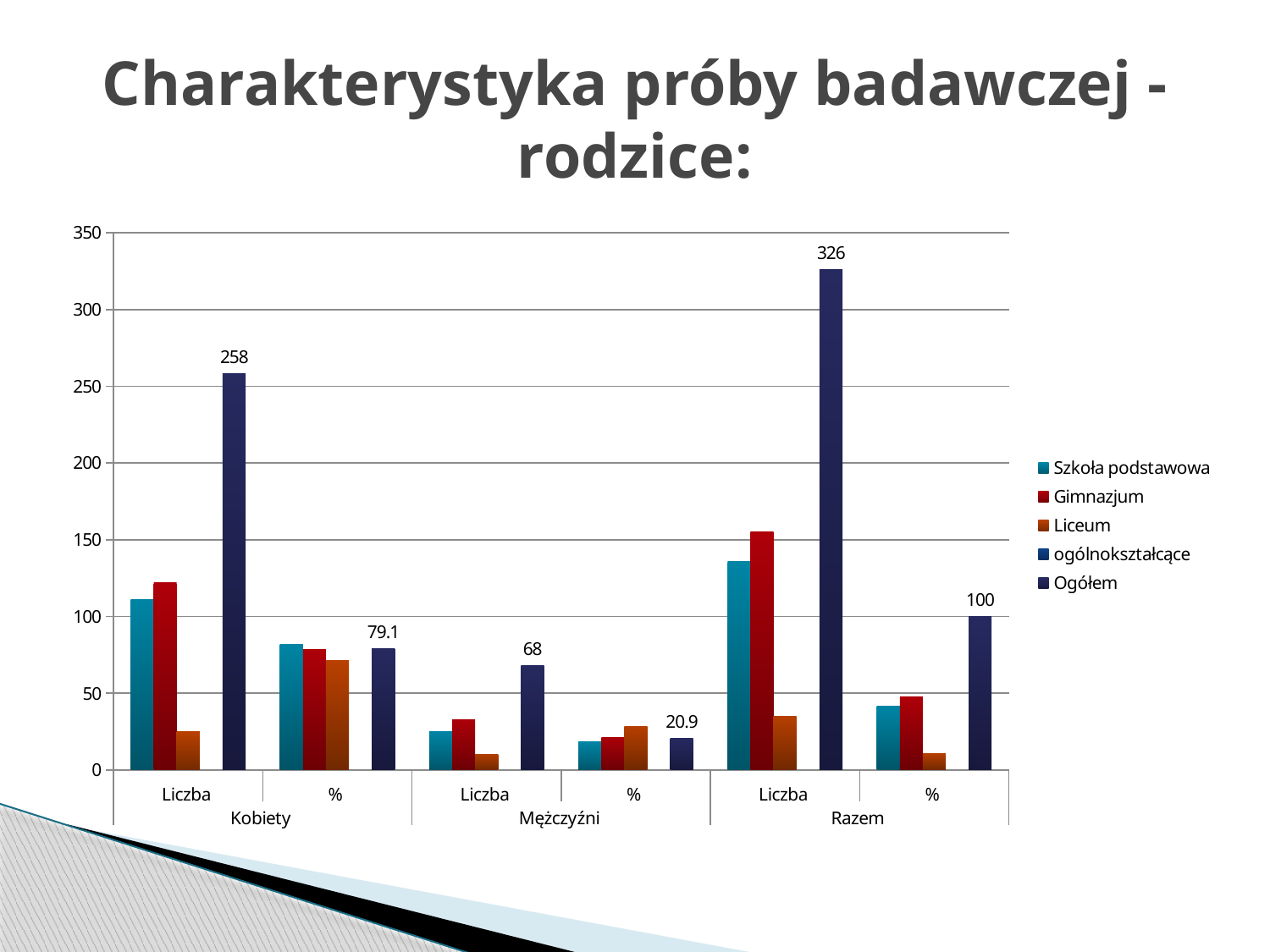
Is the Ogółem value for Mężczyźni Liczba greater or less than the Ogółem value for Kobiety %? less Is the Liceum value for Kobiety Liczba greater or less than 50? less How many series does the legend list? 5 Which category has the lowest Ogółem value? Mężczyźni % Is the Gimnazjum value for Razem Liczba greater or less than 150? greater Which category has the highest Ogółem value? Razem Liczba What kind of chart is shown on the slide? Bar chart What is the Ogółem value for Kobiety %? 79.1 What is the Ogółem value for Mężczyźni %? 20.9 What is the Ogółem value for Kobiety Liczba? 258 What is the difference between the Ogółem values for Razem Liczba and Kobiety Liczba? 68 What is the Ogółem value for Razem Liczba? 326